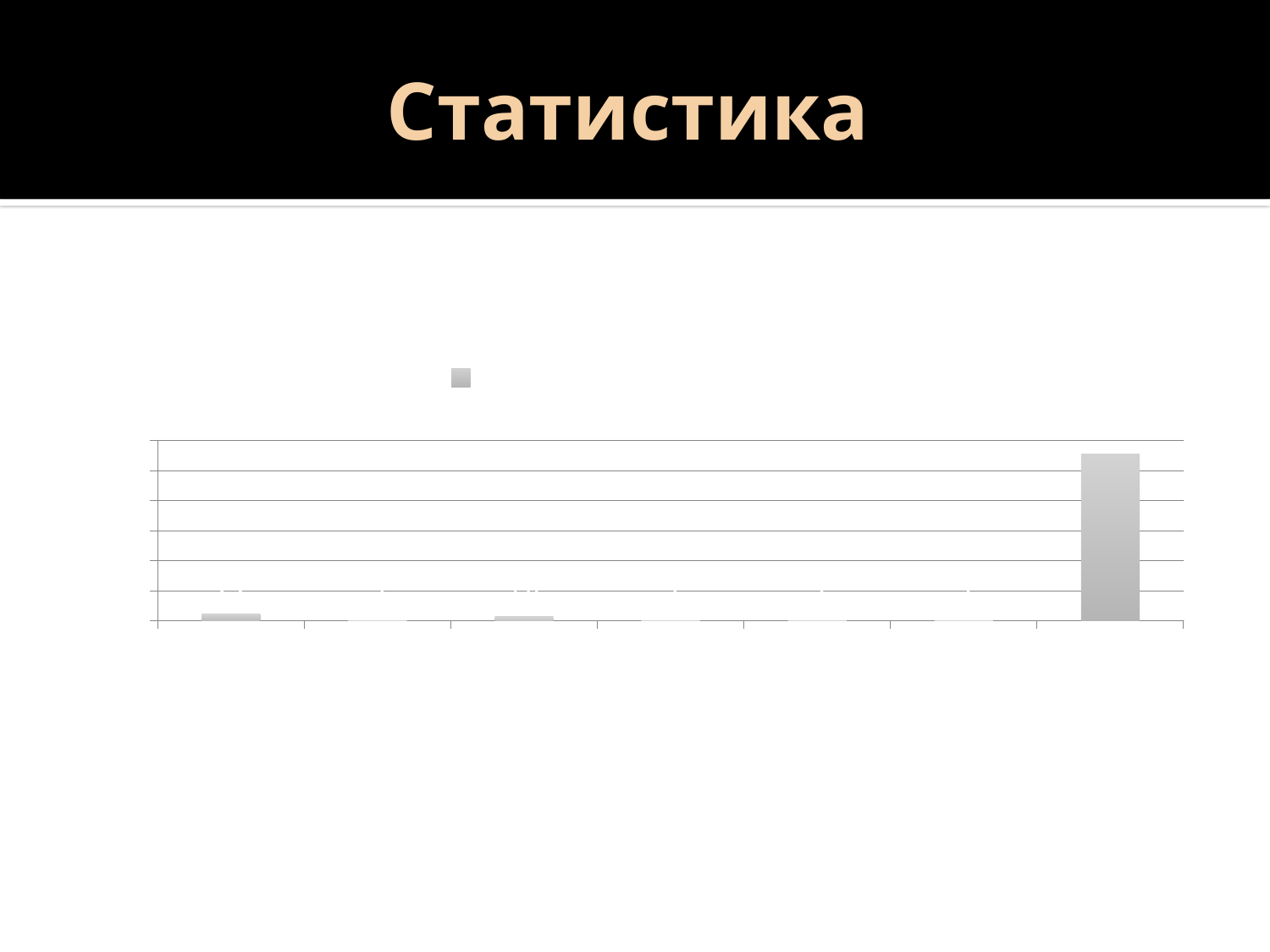
How many categories are plotted along the x axis of the chart? 7 Are the bars in the chart vertical or horizontal? vertical What is the title of the slide containing the chart? Статистика What kind of chart is shown on the slide? bar chart How many series does the chart's legend list? 1 Which bar in the chart is the tallest? the rightmost (seventh) bar